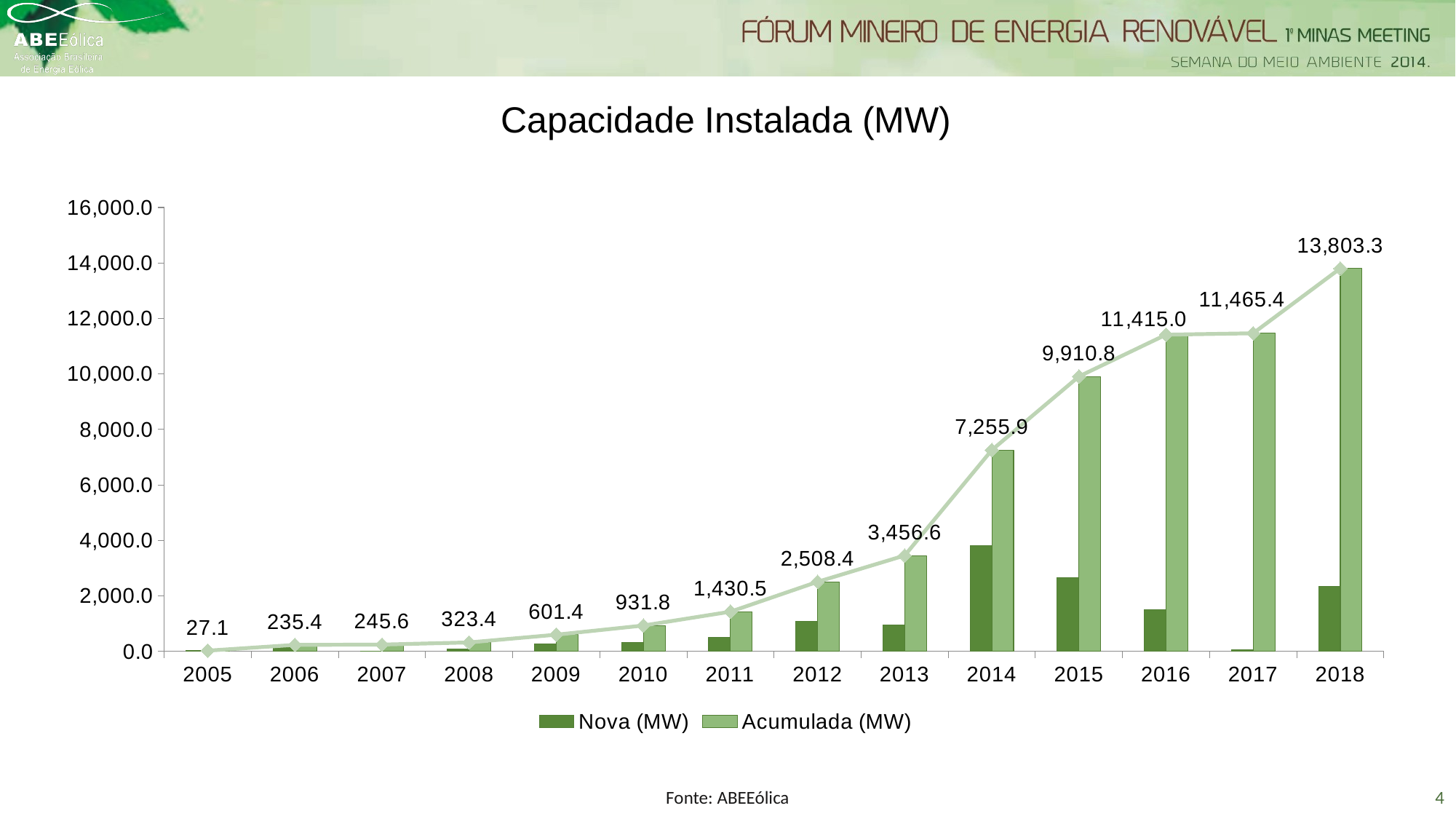
What is the Acumulada (MW) value for 2018? 13,803.3 Is the Nova (MW) value for 2016 greater or less than 2,000.0? less What is the difference between the Acumulada (MW) values for 2018 and 2017? 2,337.9 What is the difference between the Acumulada (MW) values for 2014 and 2013? 3,799.3 Which year has the highest Acumulada (MW) value? 2018 How many years are shown on the x axis? 14 How many series does the legend list? 2 Which year has the larger Acumulada (MW) value, 2006 or 2007? 2007 What is the Acumulada (MW) value for 2009? 601.4 Is the Nova (MW) value for 2014 greater or less than 2,000.0? greater Which year has the lowest Acumulada (MW) value? 2005 What is the Acumulada (MW) value for 2012? 2,508.4